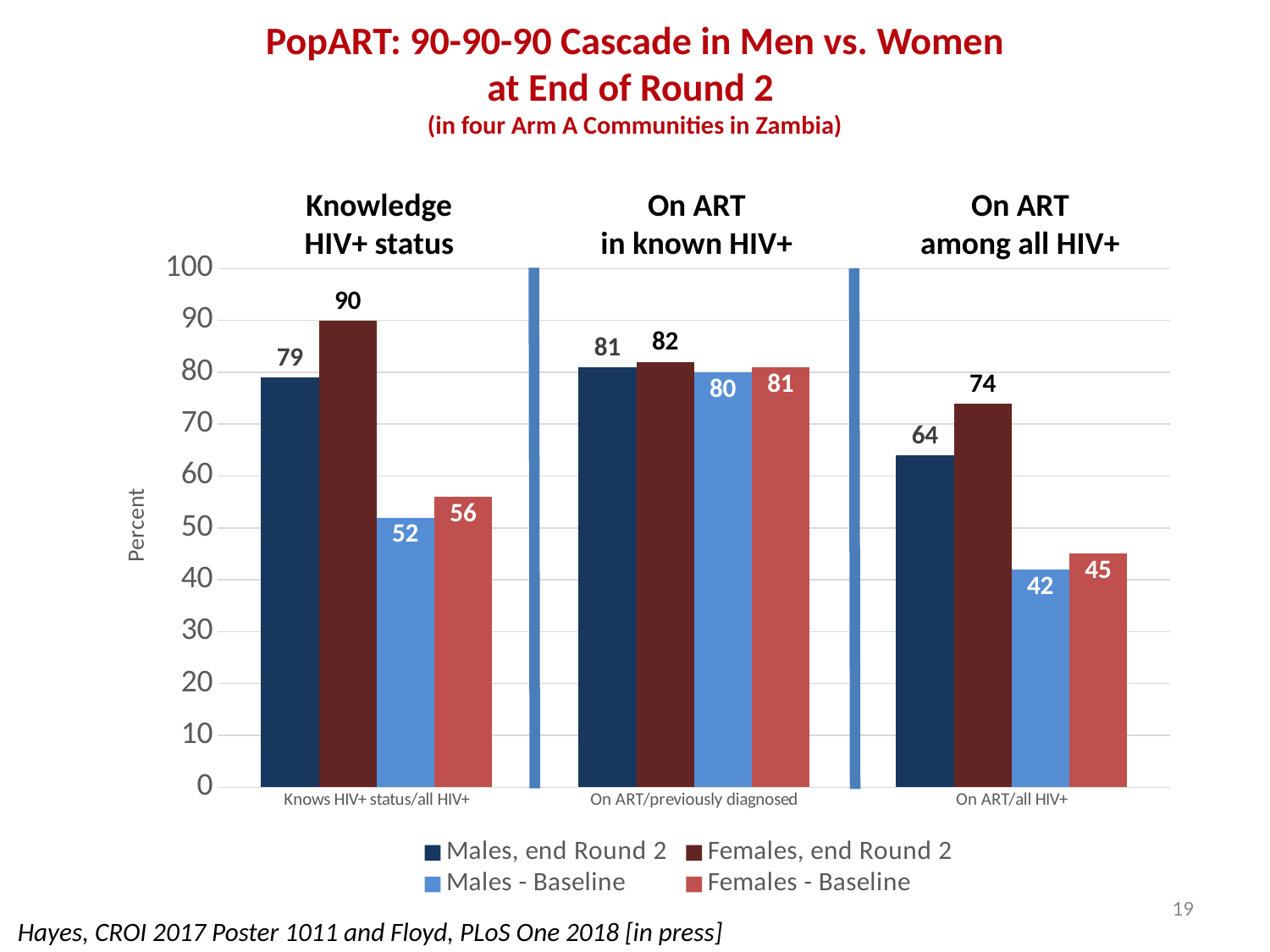
Which series has the highest value in the Knows HIV+ status/all HIV+ category? Females, end Round 2 What is the value for Males - Baseline in the On ART/all HIV+ category? 42 What is the value for Males, end Round 2 in the On ART/previously diagnosed category? 81 What kind of chart is shown on the slide? Bar chart What is the label of the y axis? Percent Which is larger: Males, end Round 2 in Knows HIV+ status/all HIV+ or Males - Baseline in the same category? Males, end Round 2 What is the difference between Females, end Round 2 and Males, end Round 2 in the On ART/all HIV+ category? 10 What is the value for Females, end Round 2 in the Knows HIV+ status/all HIV+ category? 90 Which series has the lowest value in the On ART/all HIV+ category? Males - Baseline How many categories are shown on the x axis? 3 How many series does the legend list? 4 What is the difference between Females - Baseline and Males - Baseline in the Knows HIV+ status/all HIV+ category? 4